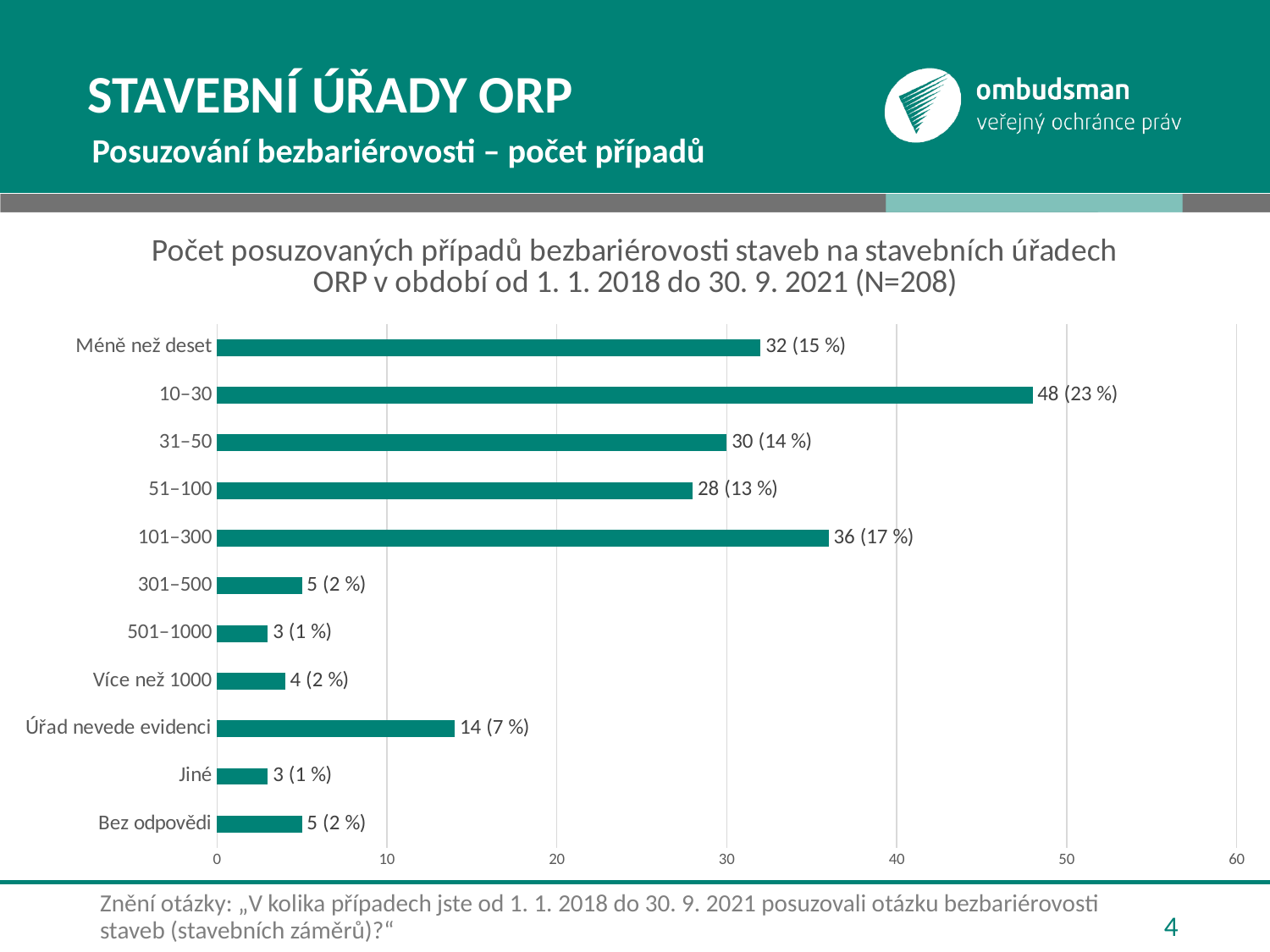
What is the value for the category "101–300"? 36 (17 %) What is the difference between the values for "Úřad nevede evidenci" and "Jiné"? 11 How many categories are shown on the chart? 11 What kind of chart is shown on the slide? bar chart What is the N value stated in the chart title? 208 What is the value for the category "Úřad nevede evidenci"? 14 (7 %) What is the maximum value shown on the horizontal axis? 60 Which is larger, the value for "31–50" or the value for "51–100"? 31–50 What is the value for the category "10–30"? 48 (23 %) Which category has the highest value? 10–30 What is the difference between the values for "10–30" and "Méně než deset"? 16 Is the value for "101–300" greater or less than 30? greater